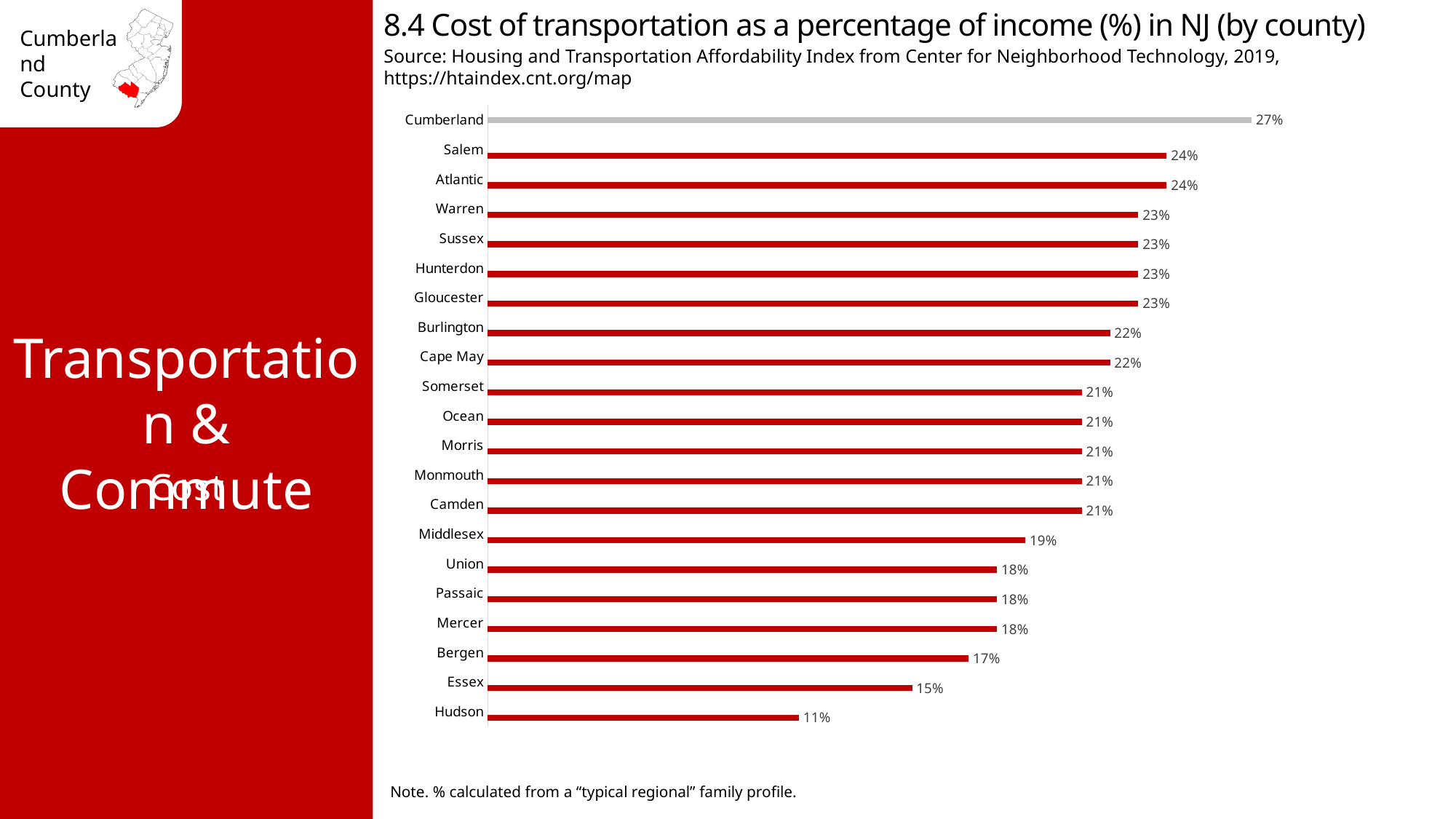
How many counties are shown in the chart? 21 What is the cost of transportation as a percentage of income for Cumberland County? 27% What is the value shown for Middlesex County? 19% Which county has the highest cost of transportation as a percentage of income? Cumberland What is the value shown for Bergen County? 17% What is the difference between the values for Salem and Essex? 9 percentage points Which county's bar is shown in a different colour (grey) from the others? Cumberland Which has a higher value, Warren or Union? Warren Which county has the lowest cost of transportation as a percentage of income? Hudson What is the value shown for Hudson County? 11% What is the difference between the values for Cumberland and Hudson? 16 percentage points What type of chart is used on this slide? Bar chart